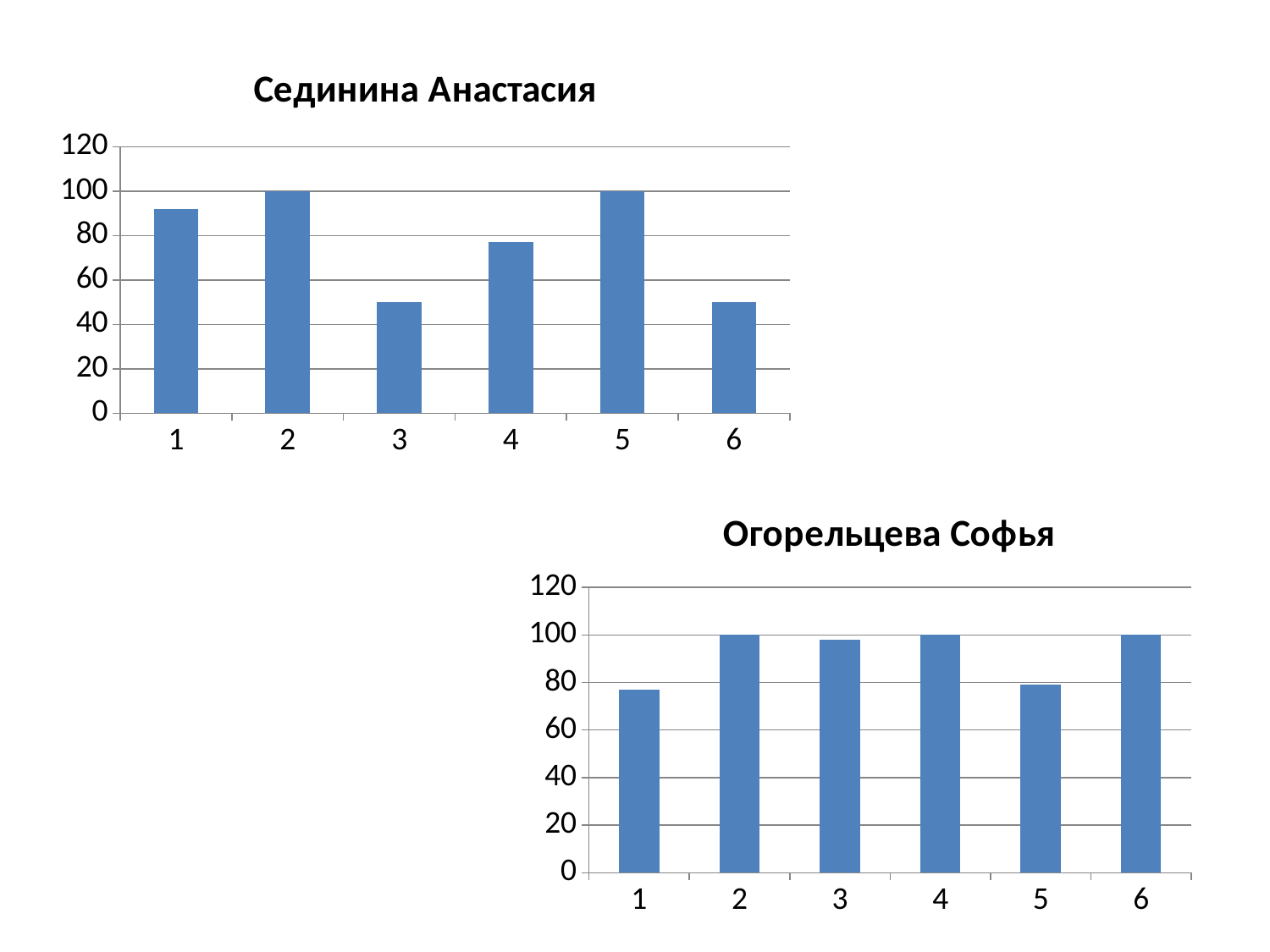
What kind of chart is the chart titled "Огорельцева Софья"? bar chart On the chart titled "Огорельцева Софья", is the value for category 5 greater or less than 100? less On the chart titled "Сединина Анастасия", which is larger, the value for category 1 or category 3? category 1 On the chart titled "Сединина Анастасия", what is the value for category 5? 100 On the chart titled "Огорельцева Софья", what is the value for category 4? 100 On the chart titled "Сединина Анастасия", is the value for category 3 greater or less than 60? less On the chart titled "Огорельцева Софья", what is the value for category 6? 100 On the chart titled "Сединина Анастасия", is the value for category 1 greater or less than 80? greater On the chart titled "Сединина Анастасия", what is the value for category 2? 100 How many categories are shown on the chart titled "Сединина Анастасия"? 6 On the chart titled "Огорельцева Софья", which is larger, the value for category 2 or category 5? category 2